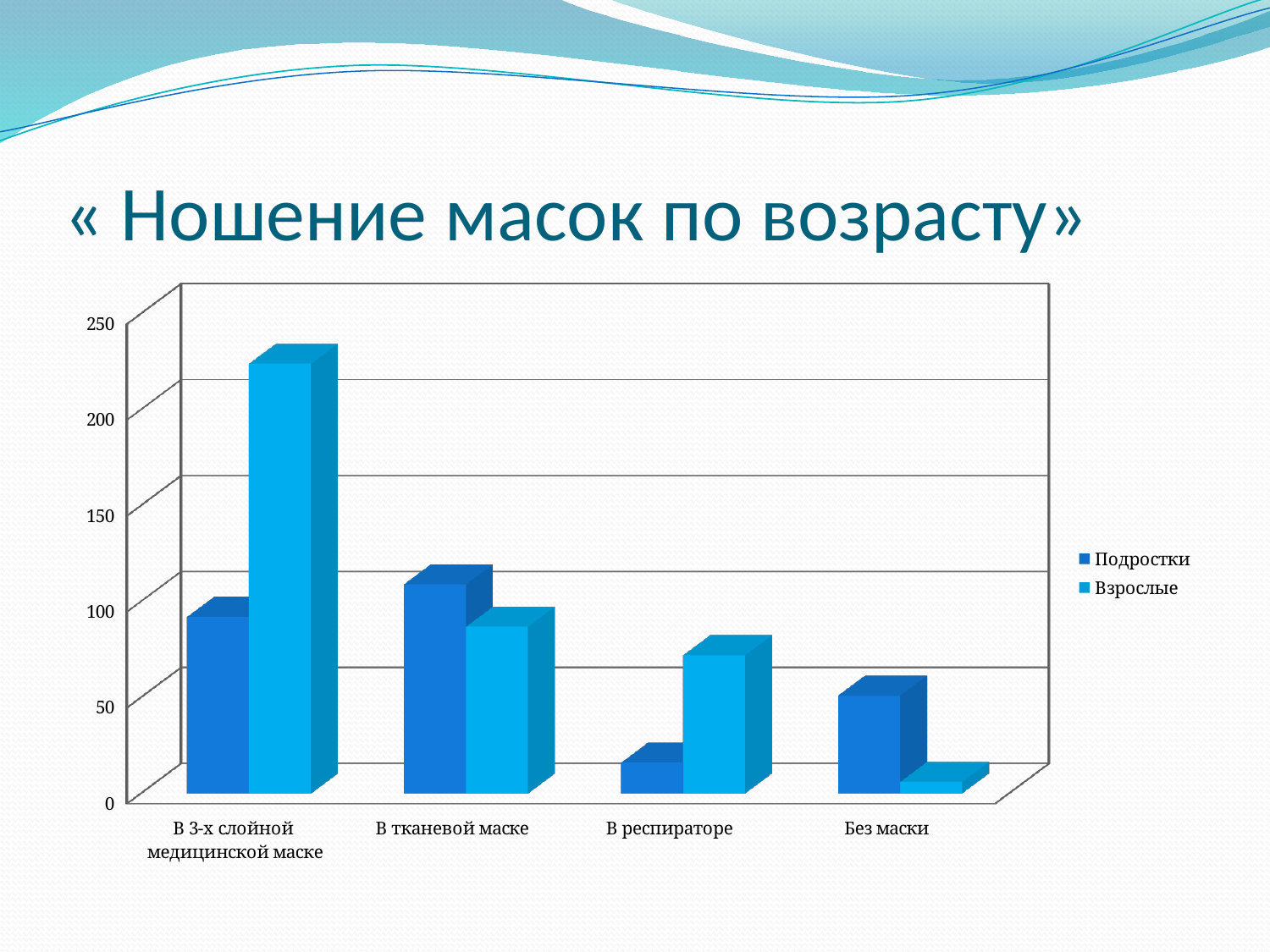
Is the value for Подростки in the category В респираторе greater or less than 50? less Which category has the lowest value for the Взрослые series? Без маски In the category Без маски, which series has the larger value, Подростки or Взрослые? Подростки Which category has the highest value for the Взрослые series? В 3-х слойной медицинской маске Which category has the lowest value for the Подростки series? В респираторе Is the value for Взрослые in the category В 3-х слойной медицинской маске greater or less than 200? greater How many series does the chart's legend list? 2 What kind of chart is shown on the slide? Bar chart What is the title of the chart on the slide? « Ношение масок по возрасту» Is the value for Взрослые in the category В респираторе greater or less than 50? greater What are the two series named in the chart's legend? Подростки and Взрослые How many categories are shown on the x axis of the chart? 4